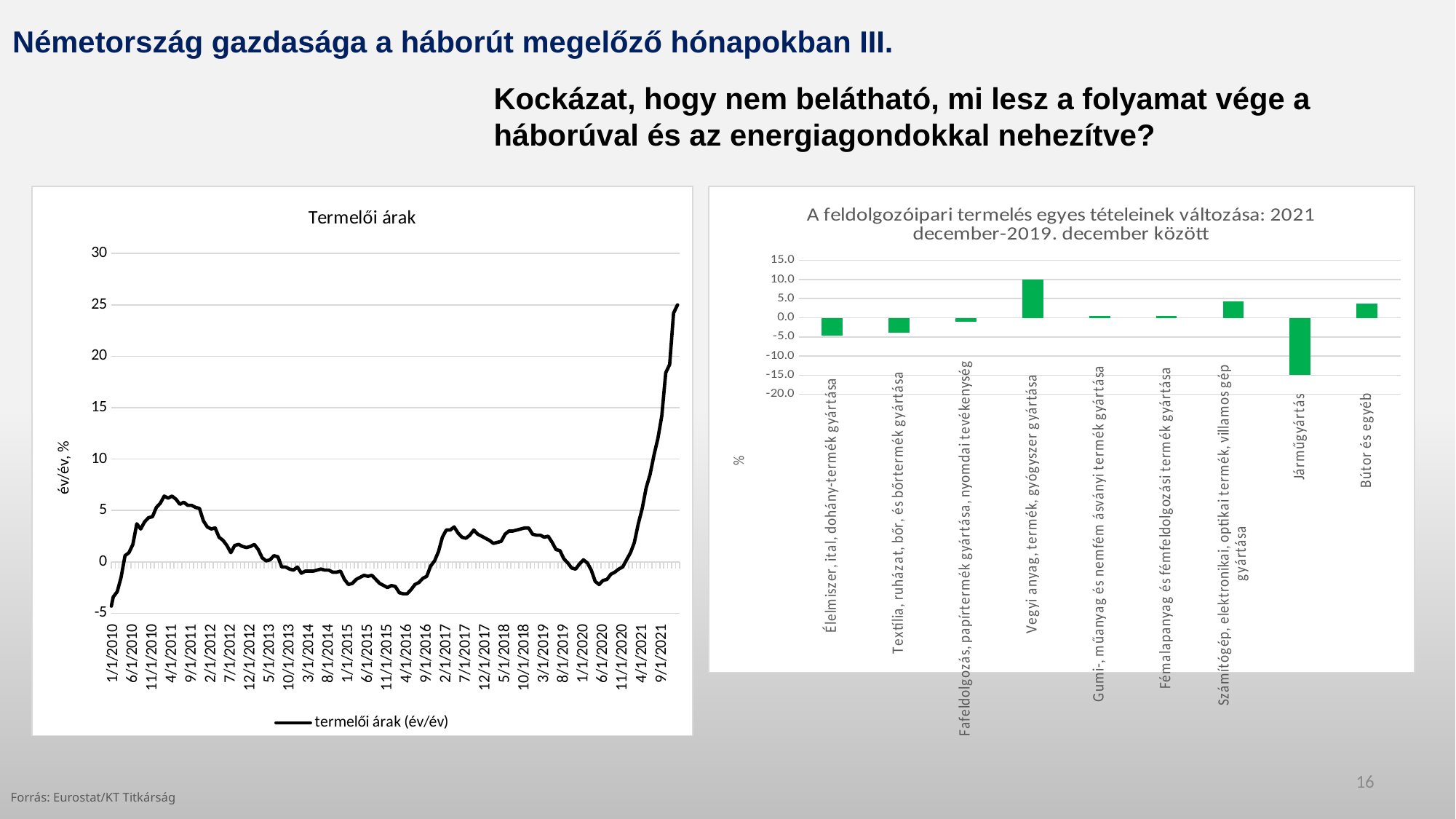
In the right chart, is the value for Járműgyártás greater or less than -10.0? less In the right chart, which category has the highest value? Vegyi anyag, termék, gyógyszer gyártása In the right chart, how many categories are shown? 9 In the right chart, which category has the lowest value? Járműgyártás In the right chart, which is larger: the value for Vegyi anyag, termék, gyógyszer gyártása or the value for Bútor és egyéb? Vegyi anyag, termék, gyógyszer gyártása What kind of chart is the left chart titled 'Termelői árak'? line chart What is the legend entry of the left chart 'Termelői árak'? termelői árak (év/év) In the left chart 'Termelői árak', is the value at the end of 2021 greater or less than 20? greater In the left chart 'Termelői árak', do the values rise or fall over the course of 2021? rise In the right chart, is the value for Vegyi anyag, termék, gyógyszer gyártása greater or less than 5.0? greater In the left chart 'Termelői árak', how many series does the legend list? 1 What kind of chart is the right chart about the change in manufacturing production items? bar chart